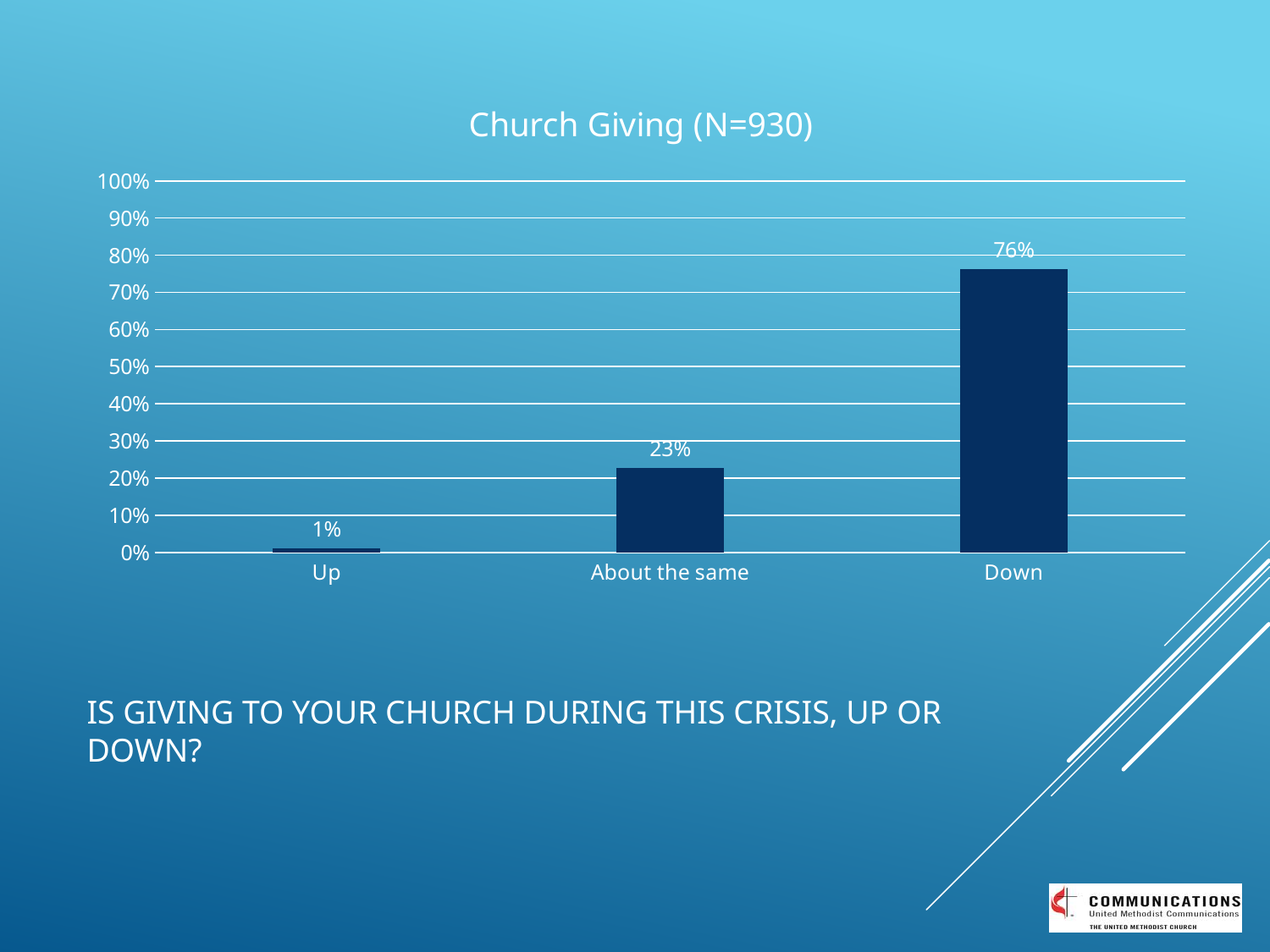
What is the difference between the values for "Down" and "About the same"? 53% Which category has the lowest value? Up How many categories are shown on the x axis? 3 Which is larger, the value for "About the same" or the value for "Up"? About the same What kind of chart is shown on the slide? bar chart Which category has the highest value? Down What is the value for "Down"? 76% What is the title of the chart? Church Giving (N=930) What is the value for "About the same"? 23% Is the value for "Down" greater or less than 70%? greater What is the difference between the values for "About the same" and "Up"? 22% What is the value for "Up"? 1%